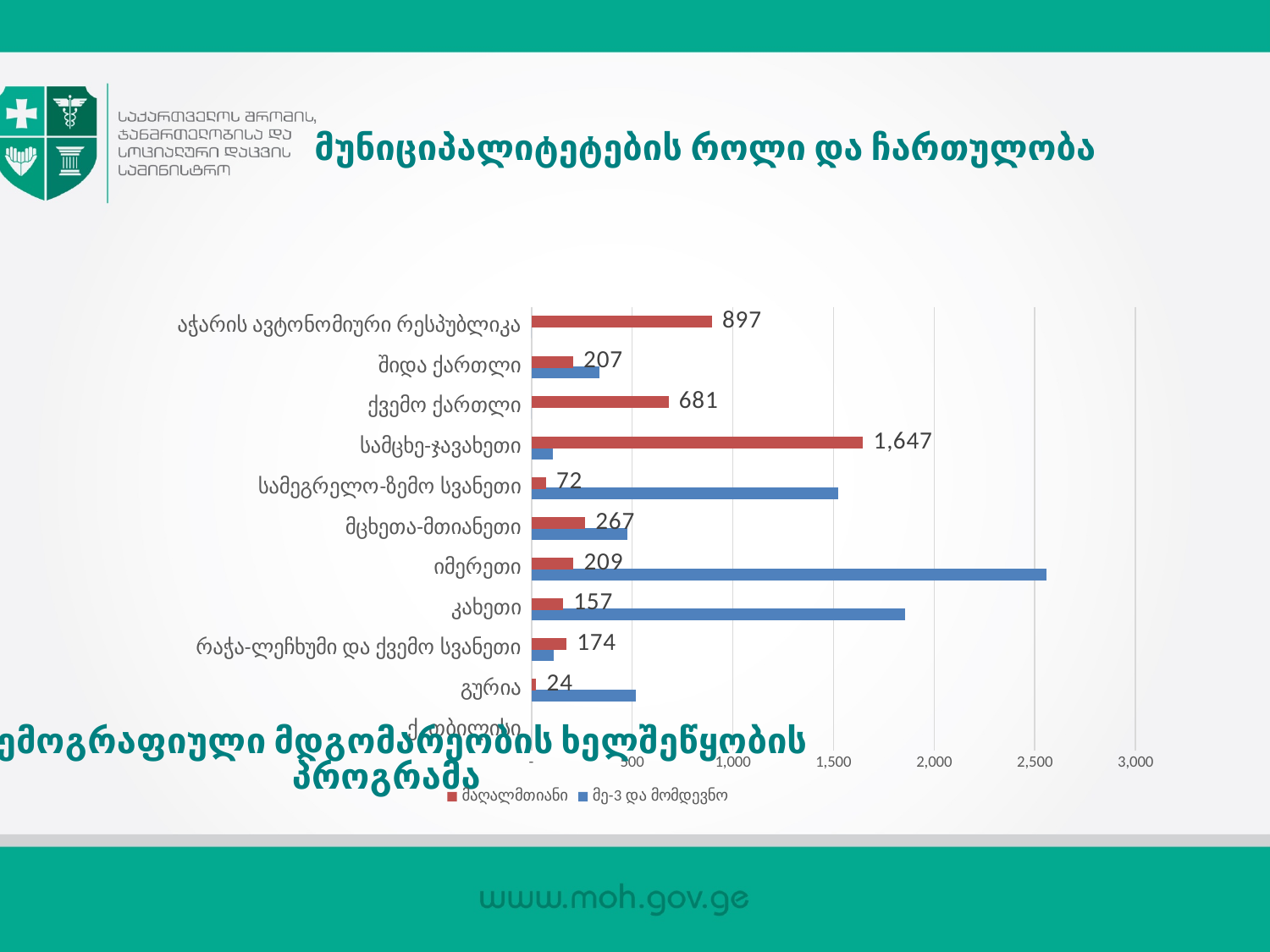
What is the მაღალმთიანი value for სამცხე-ჯავახეთი? 1,647 What is the მაღალმთიანი value for აჭარის ავტონომიური რესპუბლიკა? 897 What is the მაღალმთიანი value for კახეთი? 157 Which category has the highest მაღალმთიანი value? სამცხე-ჯავახეთი Is the მე-3 და მომდევნო value for სამეგრელო-ზემო სვანეთი greater or less than 1,000? greater What is the მაღალმთიანი value for გურია? 24 Which has the larger მაღალმთიანი value, მცხეთა-მთიანეთი or იმერეთი? მცხეთა-მთიანეთი What is the difference between the მაღალმთიანი values for ქვემო ქართლი and შიდა ქართლი? 474 Is the მე-3 და მომდევნო value for იმერეთი greater or less than 2,500? greater Which labelled category has the lowest მაღალმთიანი value? გურია What kind of chart is shown on the slide? Bar chart How many series does the legend list? 2